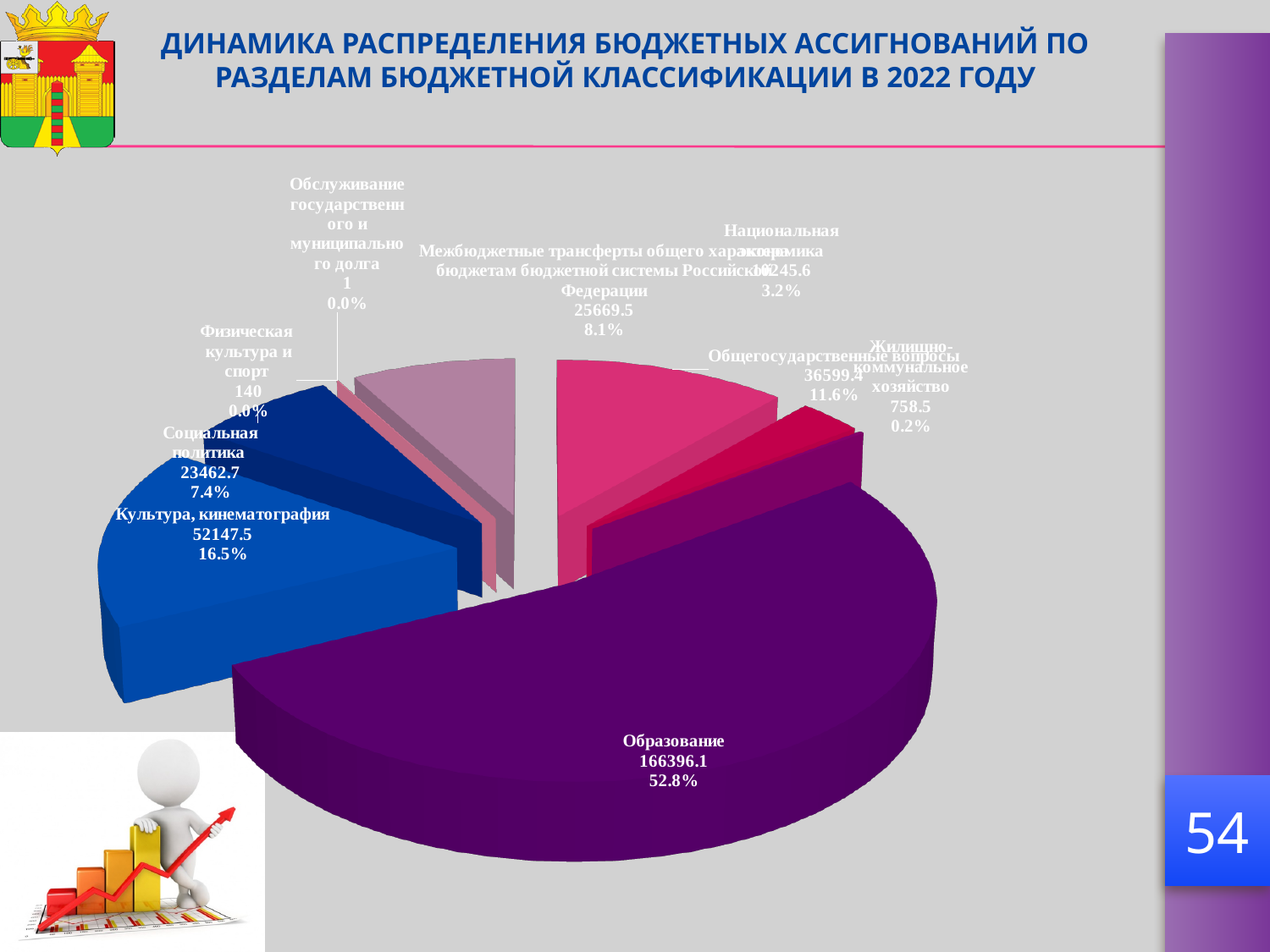
What share of the pie does Образование represent? 52.8% What is the value shown for Культура, кинематография? 52147.5 Which is larger: the value for Общегосударственные вопросы or the value for Межбюджетные трансферты общего характера бюджетам бюджетной системы Российской Федерации? Общегосударственные вопросы What share of the pie does Общегосударственные вопросы represent? 11.6% Which category has the smallest value in the pie chart? Обслуживание государственного и муниципального долга How many categories (slices) does the pie chart show? 9 What is the value shown for Социальная политика? 23462.7 What year does the chart title say the budget allocation distribution refers to? 2022 What kind of chart is shown on the slide? pie chart Which category has the largest slice of the pie? Образование What is the value shown for Образование? 166396.1 What is the difference between the values for Образование and Культура, кинематография? 114248.6